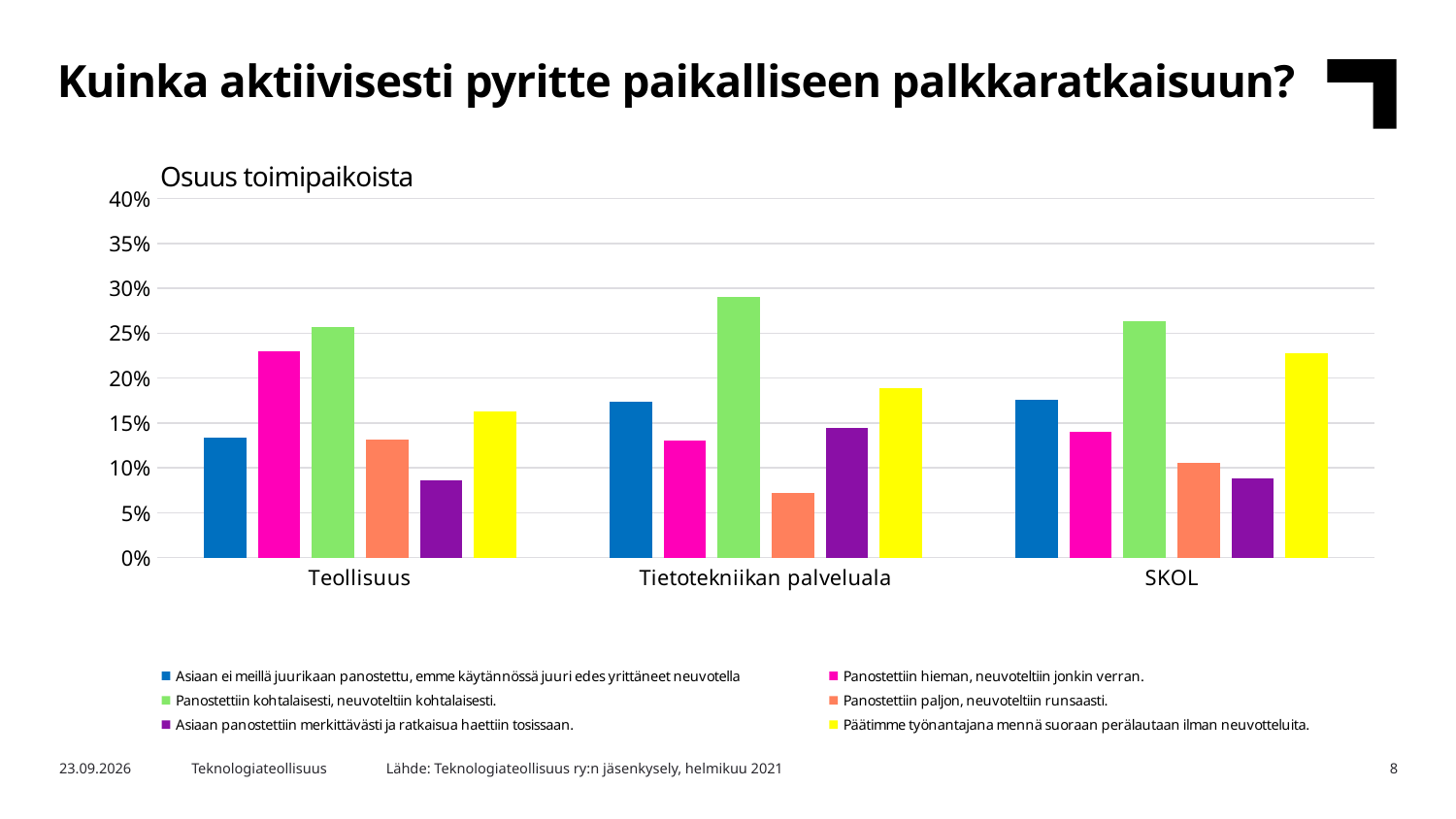
Is the value for 'Panostettiin hieman, neuvoteltiin jonkin verran.' in Teollisuus greater or less than 20%? greater What kind of chart is shown on the slide? Bar chart Which category has the larger value for 'Päätimme työnantajana mennä suoraan perälautaan ilman neuvotteluita.', Teollisuus or SKOL? SKOL Within the Tietotekniikan palveluala category, which series has the highest bar? Panostettiin kohtalaisesti, neuvoteltiin kohtalaisesti. What is the title of the chart? Osuus toimipaikoista How many series does the chart's legend list? 6 Which category has the larger value for 'Panostettiin hieman, neuvoteltiin jonkin verran.', Teollisuus or Tietotekniikan palveluala? Teollisuus Within the Teollisuus category, which series has the lowest bar? Asiaan panostettiin merkittävästi ja ratkaisua haettiin tosissaan. How many categories are shown on the x axis of the chart? 3 Is the value for 'Panostettiin paljon, neuvoteltiin runsaasti.' in SKOL greater or less than 15%? less Is the value for 'Panostettiin kohtalaisesti, neuvoteltiin kohtalaisesti.' in Tietotekniikan palveluala greater or less than 25%? greater Within the Tietotekniikan palveluala category, which series has the lowest bar? Panostettiin paljon, neuvoteltiin runsaasti.